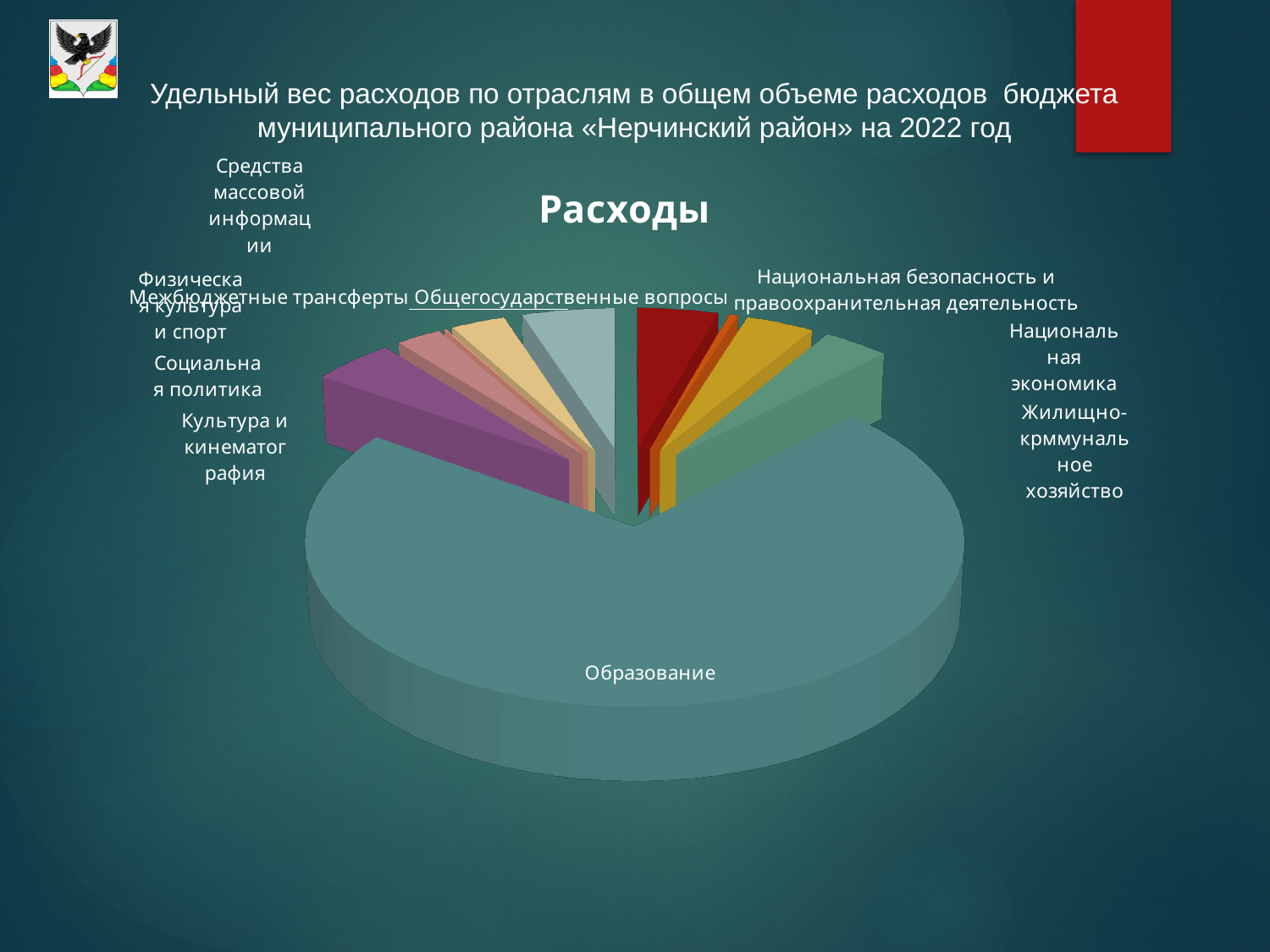
What kind of chart is shown on the slide? pie chart Which category has the largest slice of the pie? Образование Which category's slice is labelled at the bottom of the pie? Образование How many categories are labelled on the pie chart? 10 Which is larger, the slice for Образование or the slice for Социальная политика? Образование Which is larger, the slice for Образование or the slice for Национальная экономика? Образование What is the title of the chart? Расходы